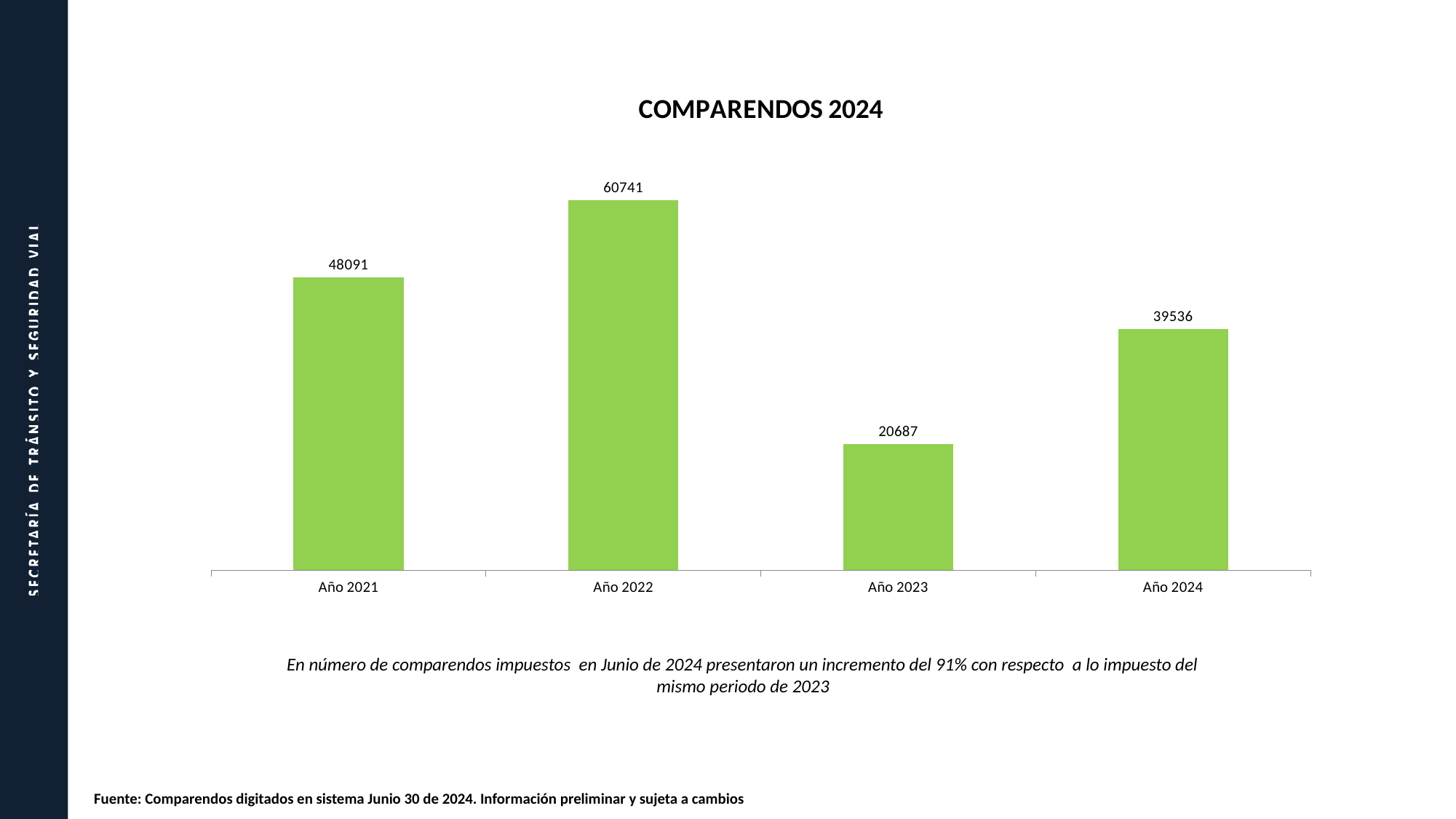
What is the title of the chart? COMPARENDOS 2024 What is the value for Año 2021? 48091 What is the difference between the values for Año 2024 and Año 2023? 18849 What is the value for Año 2023? 20687 What is the value for Año 2022? 60741 Which is larger, the value for Año 2021 or the value for Año 2024? Año 2021 What is the difference between the values for Año 2022 and Año 2021? 12650 What is the value for Año 2024? 39536 Which year has the lowest value? Año 2023 Which year has the highest value? Año 2022 What kind of chart is shown? Bar chart How many years are shown on the chart? 4